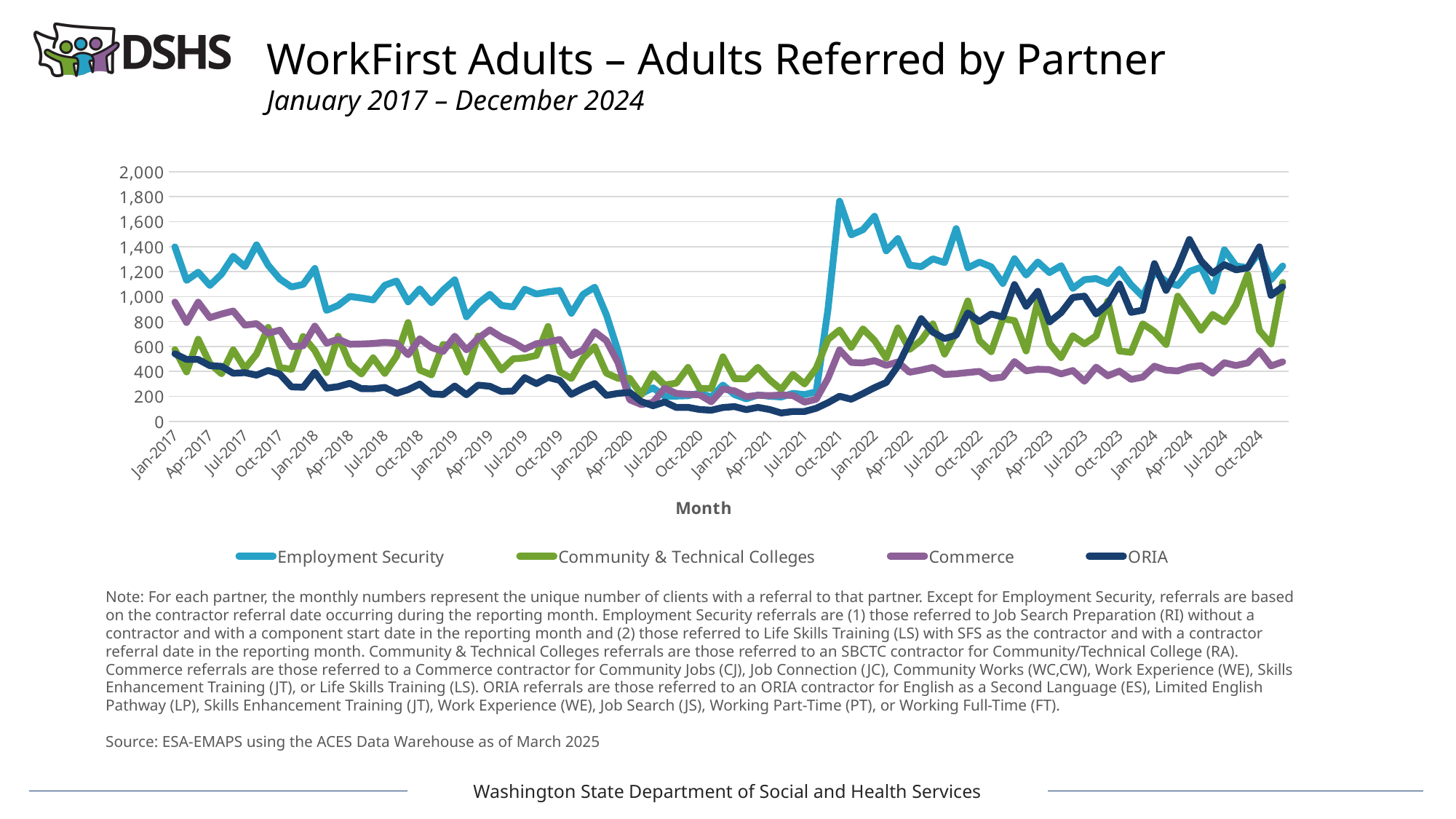
How many series does the legend list? 4 Does the ORIA series rise or fall from Jul-2021 to Apr-2024? rise In Jan-2017, which series has the higher value, Employment Security or ORIA? Employment Security In Jan-2017, which series has the higher value, Commerce or ORIA? Commerce Is the value for Employment Security in Jan-2017 greater or less than 1,000? greater What is the title of the chart? WorkFirst Adults – Adults Referred by Partner Which series reaches the highest value anywhere on the chart? Employment Security Is the value for Commerce in Jan-2017 greater or less than 600? greater What is the label of the x axis? Month What kind of chart is shown on the slide? Line chart Is the value for ORIA in Jul-2021 greater or less than 200? less